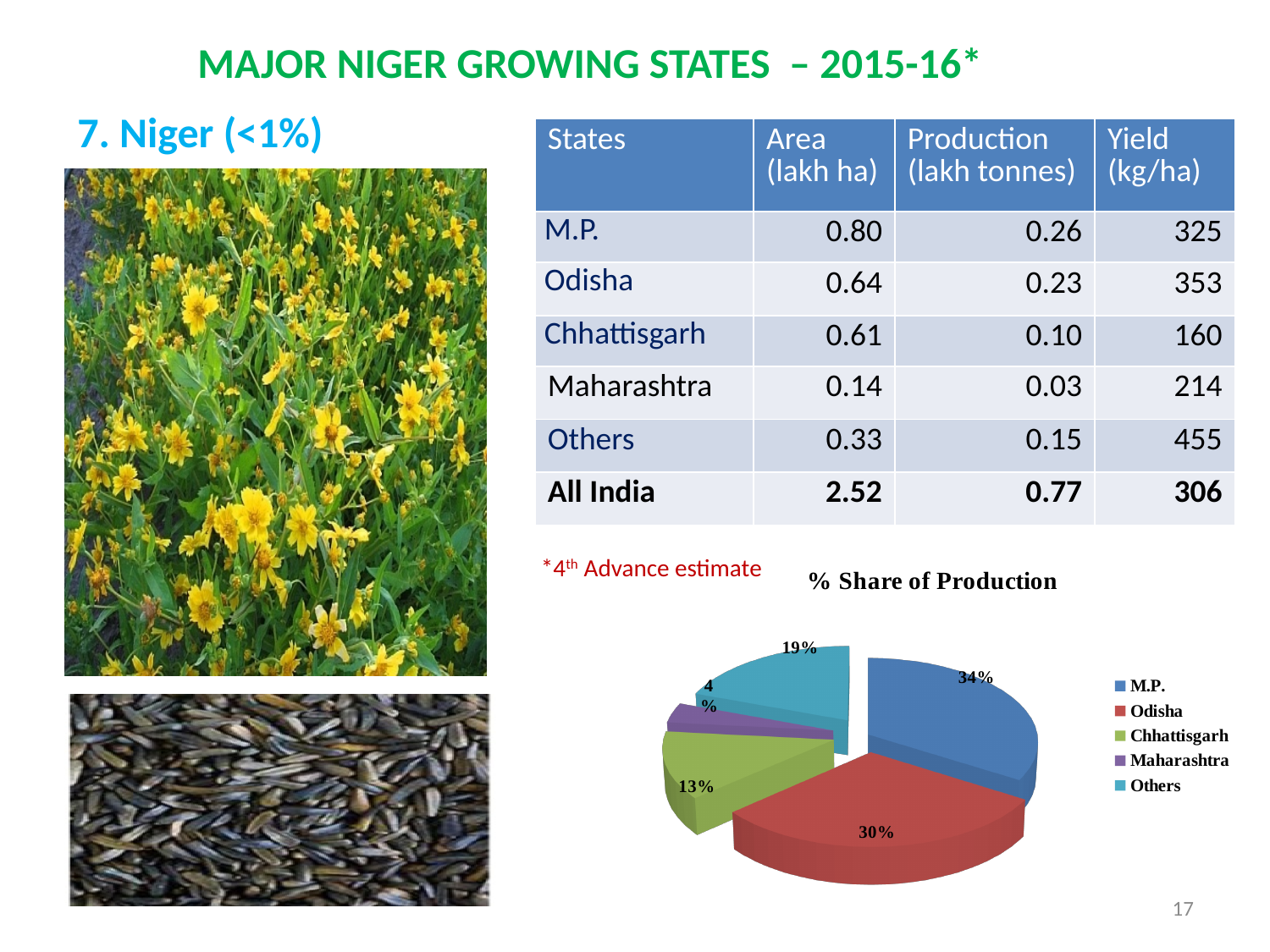
What share of production does Odisha have in the pie chart? 30% What kind of chart is shown on the slide? pie chart What is the title of the chart? % Share of Production How many entries does the chart legend list? 5 What share of production does M.P. have in the pie chart? 34% Which category has the smallest share of production in the pie chart? Maharashtra What share of production does Others have in the pie chart? 19% Which has a larger share of production in the pie chart, Chhattisgarh or Others? Others How many slices does the pie chart have? 5 What is the difference in percentage points between the shares of M.P. and Odisha in the pie chart? 4 Which state has the largest share of production in the pie chart? M.P.